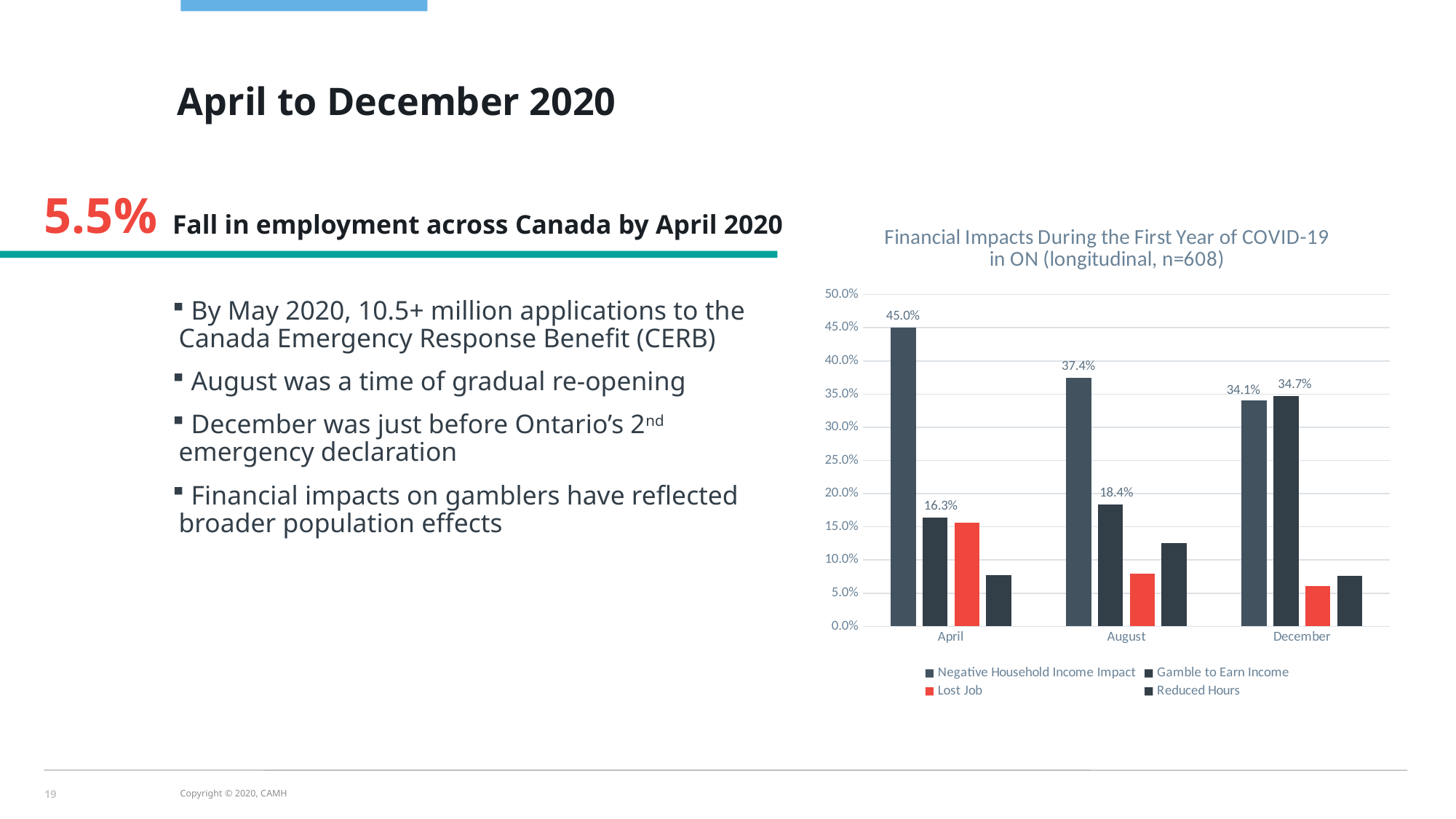
What is the value for Gamble to Earn Income in August? 18.4% Which is larger in August: Negative Household Income Impact or Gamble to Earn Income? Negative Household Income Impact What is the value for Gamble to Earn Income in December? 34.7% Is the value for Lost Job in December greater or less than 10.0%? less What kind of chart is shown on the slide? bar chart Does Negative Household Income Impact rise or fall from April to December? fall In which month is Negative Household Income Impact highest? April How many series does the legend list? 4 What is the value for Negative Household Income Impact in August? 37.4% In which month is Gamble to Earn Income lowest? April What is the difference between Negative Household Income Impact in April and in December? 10.9 percentage points What is the value for Negative Household Income Impact in April? 45.0%